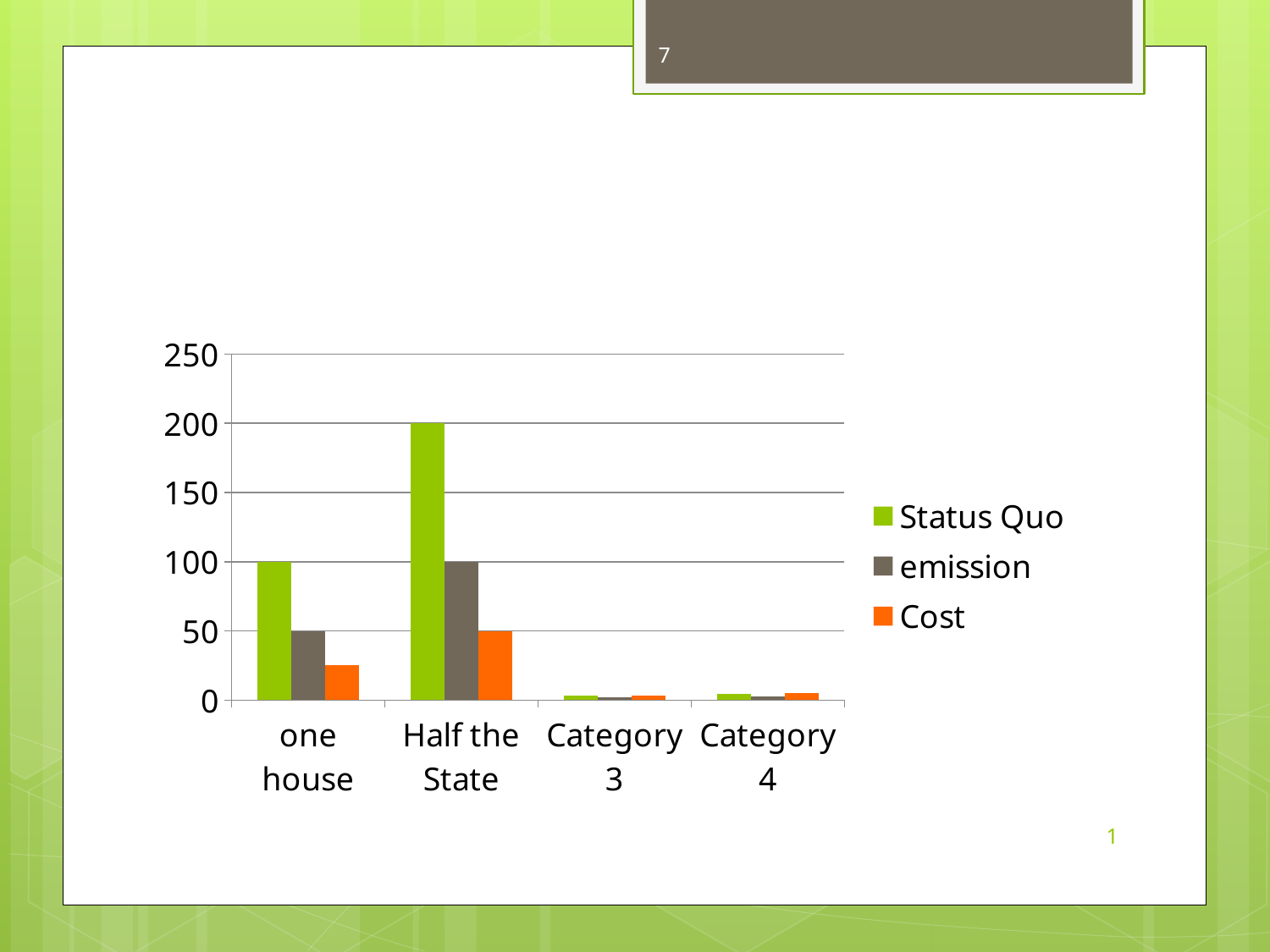
Is the Cost value for one house greater or less than 50? less What is the Cost value for Half the State? 50 What is the Status Quo value for one house? 100 What is the Status Quo value for Half the State? 200 What is the difference between the Status Quo and emission values for Half the State? 100 What is the emission value for Half the State? 100 Which is larger, the emission value for one house or the emission value for Half the State? Half the State Which legend entry is shown in orange? Cost How many series does the legend list? 3 What kind of chart is shown on the slide? bar chart How many categories are shown on the x axis? 4 Which category has the highest Status Quo value? Half the State